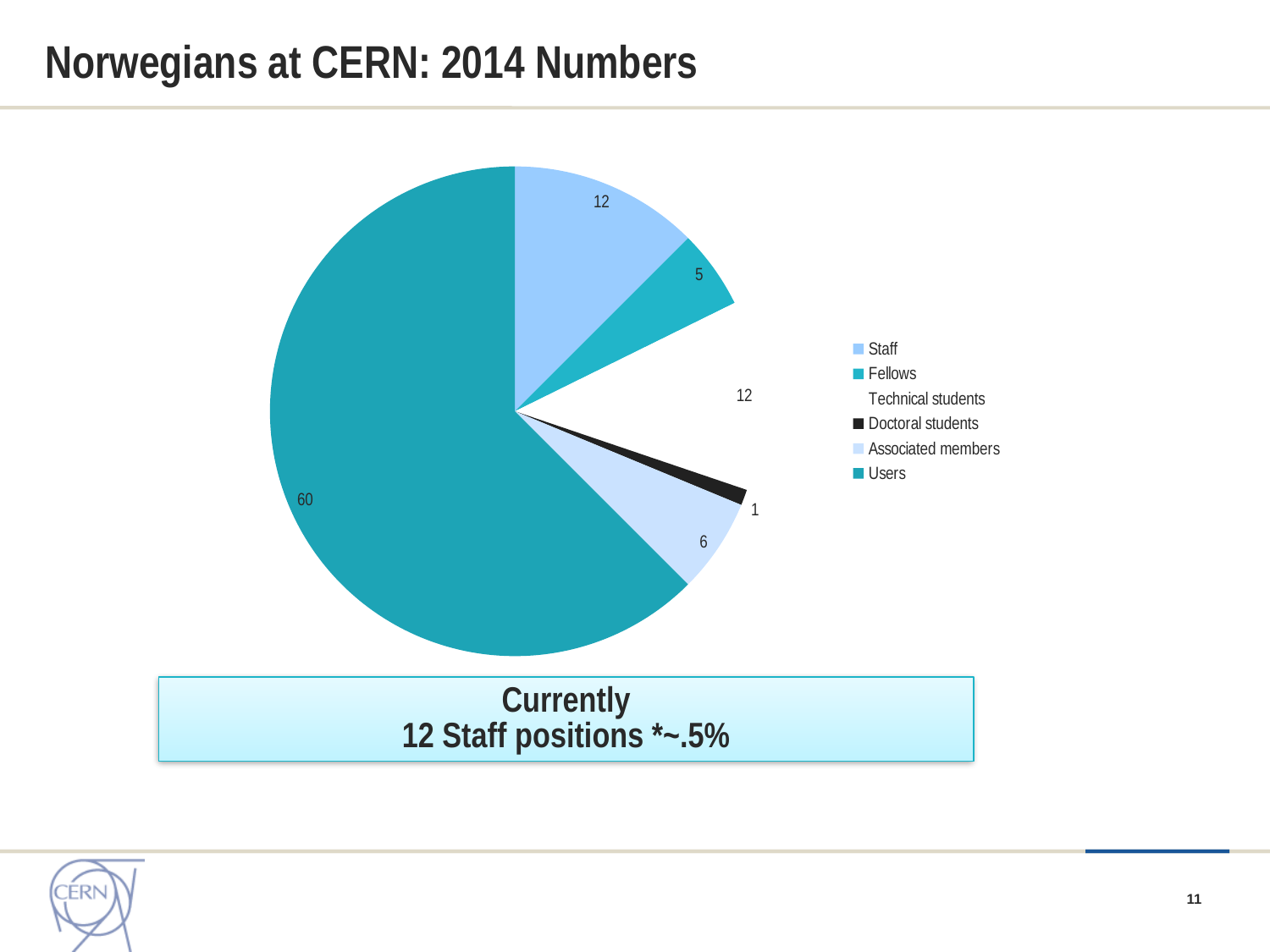
Which category has the largest slice in the pie chart? Users Which is larger, the value for Fellows or the value for Associated members? Associated members How many categories does the legend of the pie chart list? 6 Which category has the smallest slice in the pie chart? Doctoral students What is the title of the slide containing the pie chart? Norwegians at CERN: 2014 Numbers What is the value for Associated members in the pie chart? 6 What share of the pie do Users represent? 62.5% What is the value for Doctoral students in the pie chart? 1 What kind of chart is shown on the slide? pie chart What is the difference between the number of Users and the number of Staff? 48 What is the value for Fellows in the pie chart? 5 How many Users are shown in the pie chart? 60